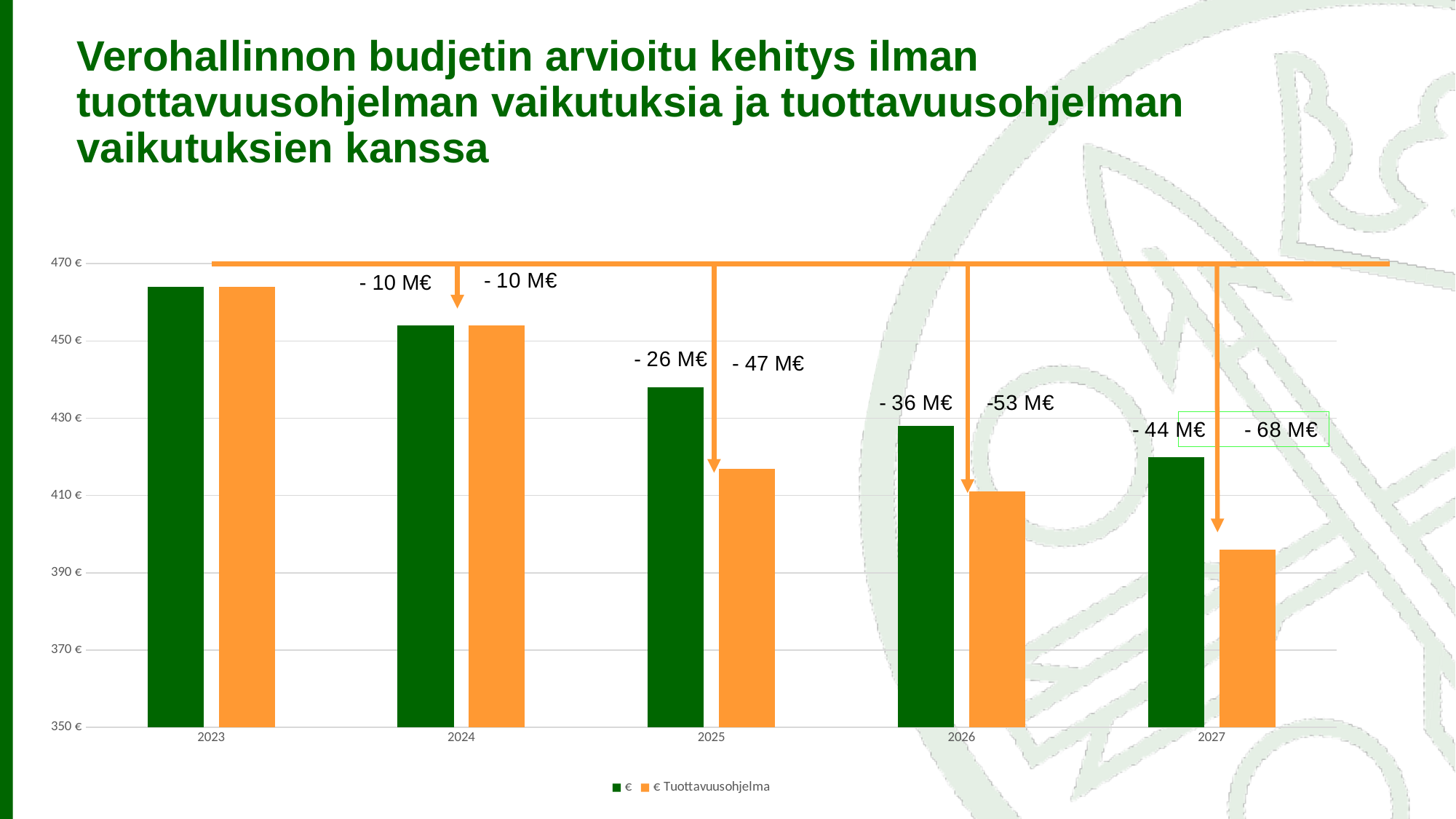
In 2027, which bar is taller, the green one or the orange one? green What kind of chart is shown on the slide? bar chart Is the value of the green bar for 2023 greater or less than 450 €? greater Do the values of the orange series rise or fall from 2023 to 2027? fall How many series does the chart legend list? 2 What is the name of the orange series in the legend? € Tuottavuusohjelma What reduction is annotated above the orange bar for 2027? - 68 M€ Is the value of the green bar for 2025 greater or less than 430 €? greater How many years are shown on the x axis of the chart? 5 Is the value of the orange bar for 2027 greater or less than 410 €? less In which year is the orange series bar lowest? 2027 In which year is the green series bar highest? 2023